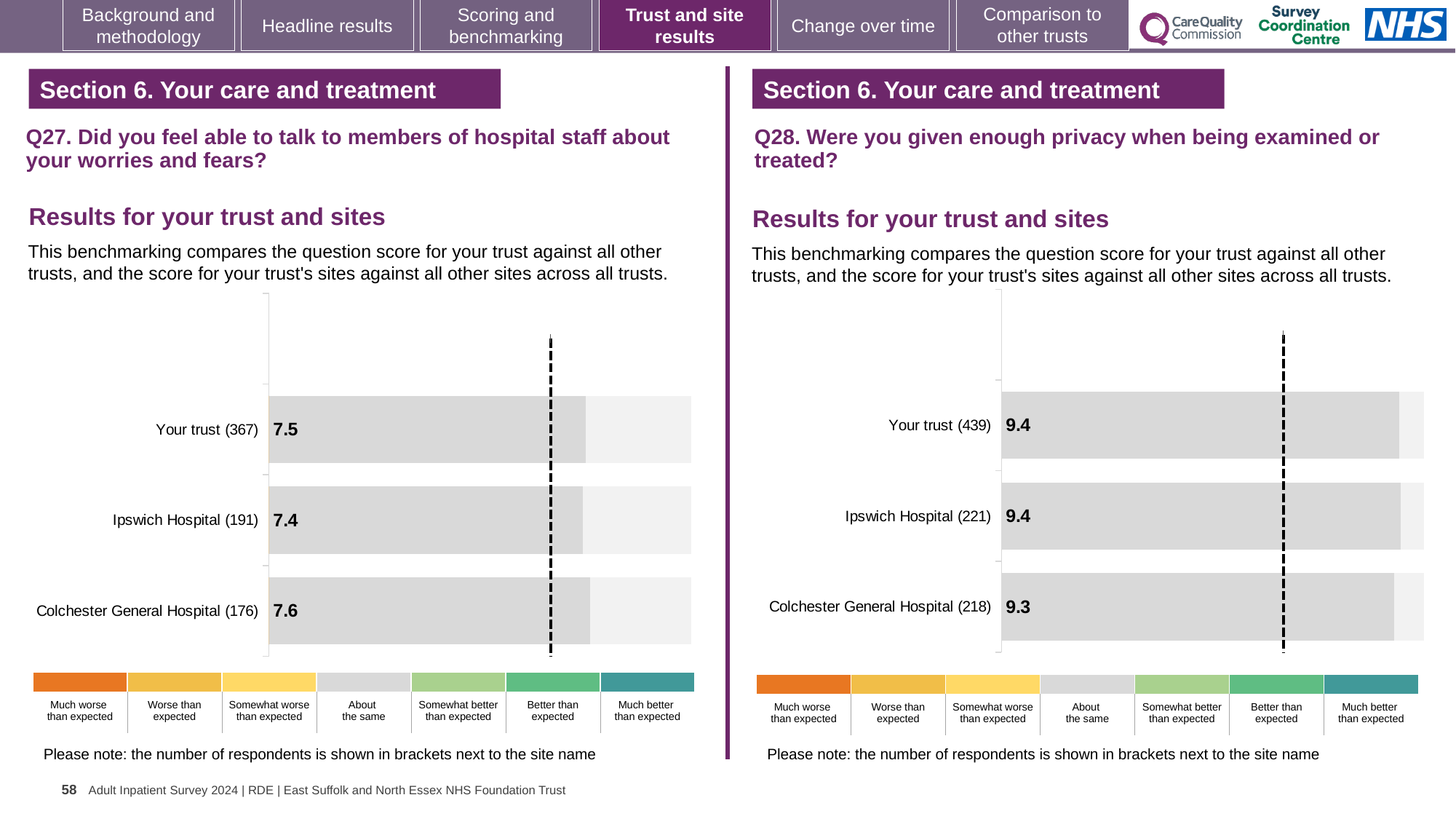
In the Q27 chart on the left, what is the score for Your trust? 7.5 In the Q28 chart on the right, which is larger: the score for Ipswich Hospital or Colchester General Hospital? Ipswich Hospital In the Q27 chart on the left, what is the difference between the scores for Colchester General Hospital and Ipswich Hospital? 0.2 In the Q27 chart on the left, which site or trust has the highest score? Colchester General Hospital In the Q28 chart on the right, which site or trust has the lowest score? Colchester General Hospital How many bars are plotted in the Q27 chart on the left? 3 In the Q28 chart on the right, what is the score for Your trust? 9.4 In the Q27 chart on the left, which site or trust has the lowest score? Ipswich Hospital What kind of chart is used in the Q28 chart on the right? Bar chart In the Q28 chart on the right, what is the score for Colchester General Hospital? 9.3 In the Q27 chart on the left, what is the score for Ipswich Hospital? 7.4 In the Q28 chart on the right, how many respondents are shown in brackets for Your trust? 439